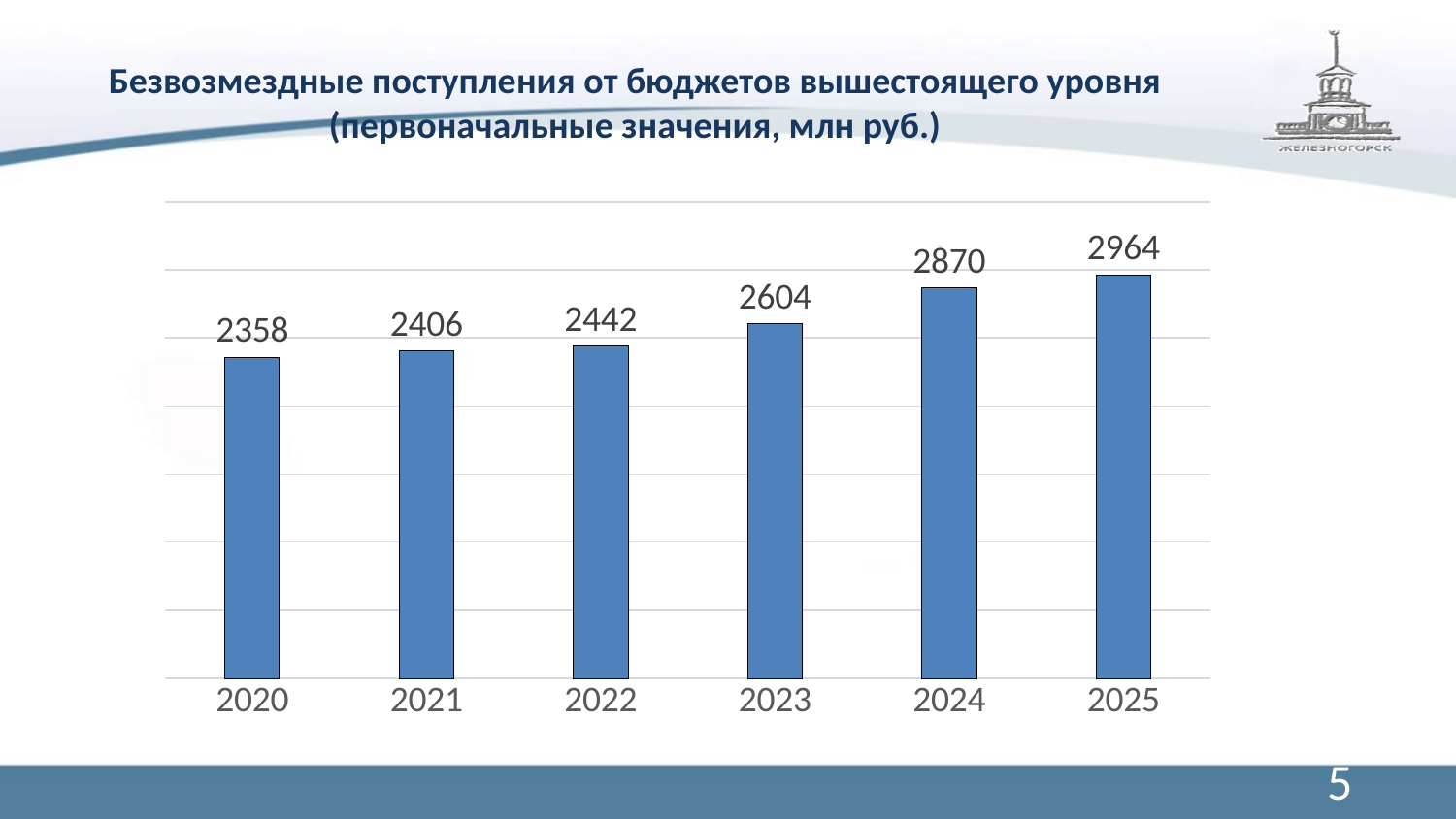
Which year has the highest value? 2025 What is the value for 2020? 2358 What is the difference between the values for 2025 and 2020? 606 What unit is stated in the chart title? млн руб. Which year has the lowest value? 2020 What is the value for 2023? 2604 Do the values rise or fall from 2020 to 2025? rise How many years are shown on the chart? 6 What kind of chart is shown on the slide? bar chart What is the difference between the values for 2024 and 2023? 266 What is the value for 2025? 2964 Which is larger, the value for 2022 or the value for 2024? 2024